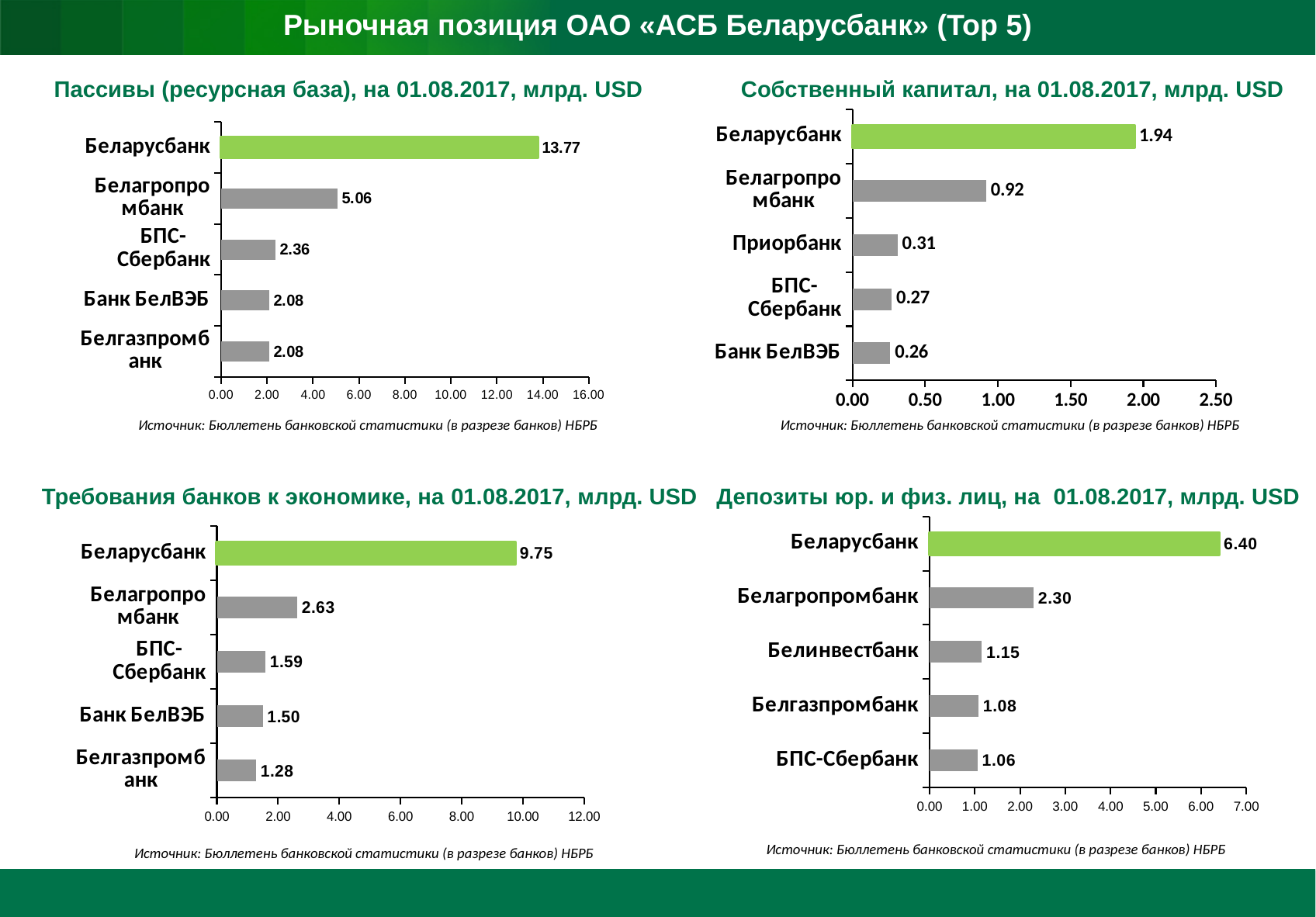
In the chart 'Депозиты юр. и физ. лиц, на 01.08.2017, млрд. USD', what is the value for Белинвестбанк? 1.15 What type of chart is 'Пассивы (ресурсная база), на 01.08.2017, млрд. USD'? Bar chart In the chart 'Собственный капитал, на 01.08.2017, млрд. USD', what is the value for Приорбанк? 0.31 In the chart 'Требования банков к экономике, на 01.08.2017, млрд. USD', which bank has the highest value? Беларусбанк In the chart 'Собственный капитал, на 01.08.2017, млрд. USD', which bank has the lowest value? Банк БелВЭБ In the chart 'Пассивы (ресурсная база), на 01.08.2017, млрд. USD', what is the value for Беларусбанк? 13.77 How many banks are shown in the chart 'Депозиты юр. и физ. лиц, на 01.08.2017, млрд. USD'? 5 In the chart 'Требования банков к экономике, на 01.08.2017, млрд. USD', which is larger: БПС-Сбербанк or Банк БелВЭБ? БПС-Сбербанк In the chart 'Пассивы (ресурсная база), на 01.08.2017, млрд. USD', what is the value for Белагропромбанк? 5.06 In the chart 'Собственный капитал, на 01.08.2017, млрд. USD', what is the difference between Беларусбанк and Белагропромбанк? 1.02 In the chart 'Депозиты юр. и физ. лиц, на 01.08.2017, млрд. USD', what is the difference between Беларусбанк and Белагропромбанк? 4.10 In the chart 'Требования банков к экономике, на 01.08.2017, млрд. USD', what is the value for Белгазпромбанк? 1.28